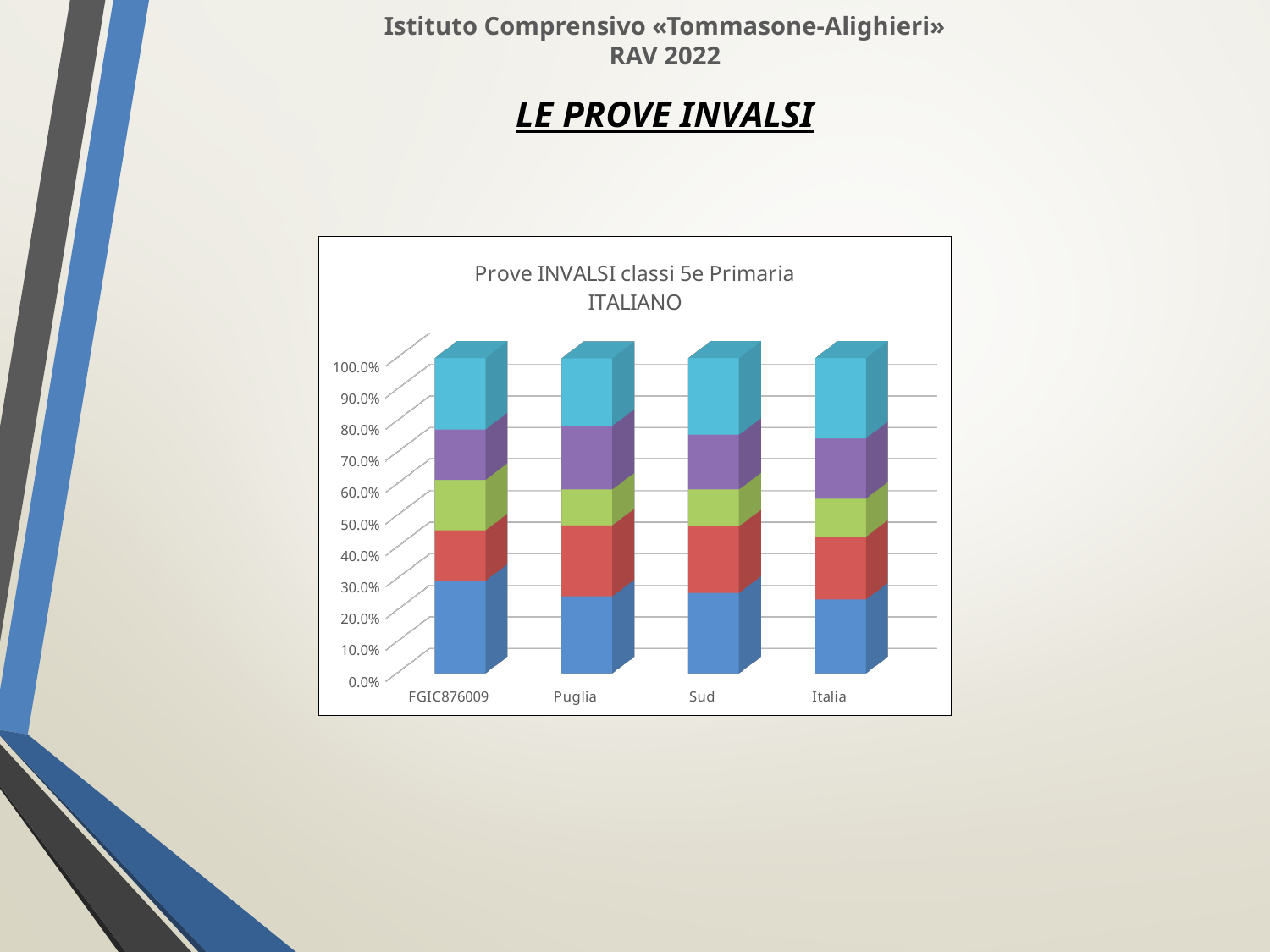
Does the top of the red segment in the Italia bar lie above or below the 50.0% line? below Is the bottom (blue) segment of the Italia bar greater or less than 30.0%? less Which category is shown first on the x axis of the chart? FGIC876009 What kind of chart is shown on the slide? stacked bar chart Is the bottom (blue) segment larger for FGIC876009 or for Italia? FGIC876009 How many categories are shown on the x axis of the chart? 4 Is the bottom (blue) segment of the FGIC876009 bar greater or less than 20.0%? greater What is the title of the chart? Prove INVALSI classi 5e Primaria ITALIANO What is the total height of the stacked bar for Italia? 100.0% Which bar has the largest bottom (blue) segment? FGIC876009